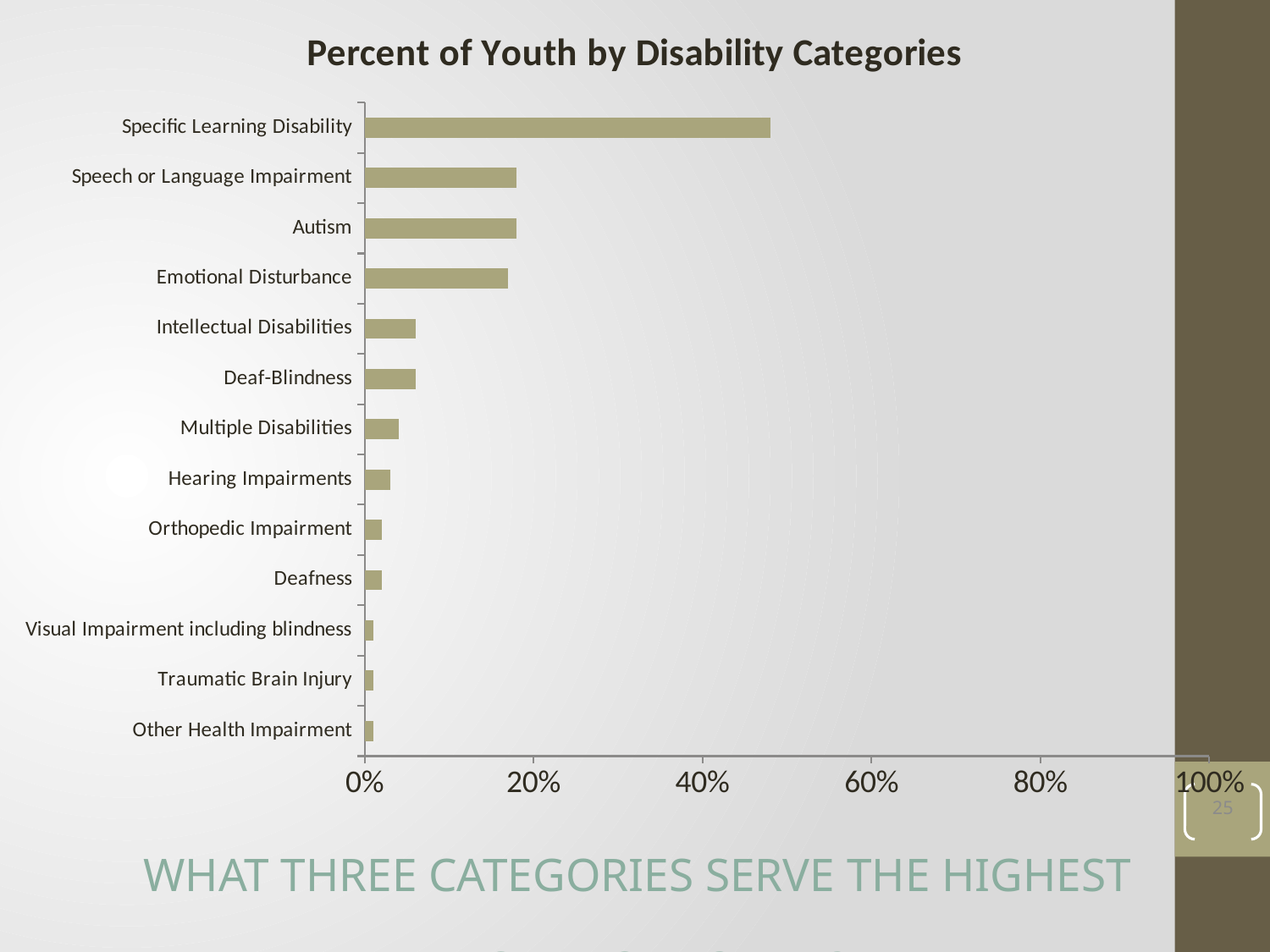
Which is larger, the value for Multiple Disabilities or the value for Deaf-Blindness? Deaf-Blindness Which is larger, the value for Emotional Disturbance or the value for Intellectual Disabilities? Emotional Disturbance Is the value for Emotional Disturbance greater or less than 20%? less Is the value for Specific Learning Disability greater or less than 60%? less Is the value for Specific Learning Disability greater or less than 40%? greater Which disability category has the highest percent of youth? Specific Learning Disability What is the highest value shown on the horizontal axis of the chart? 100% How many disability categories are plotted in the chart? 13 What is the title of the chart? Percent of Youth by Disability Categories What type of chart is shown on the slide? bar chart Which is larger, the value for Specific Learning Disability or the value for Autism? Specific Learning Disability